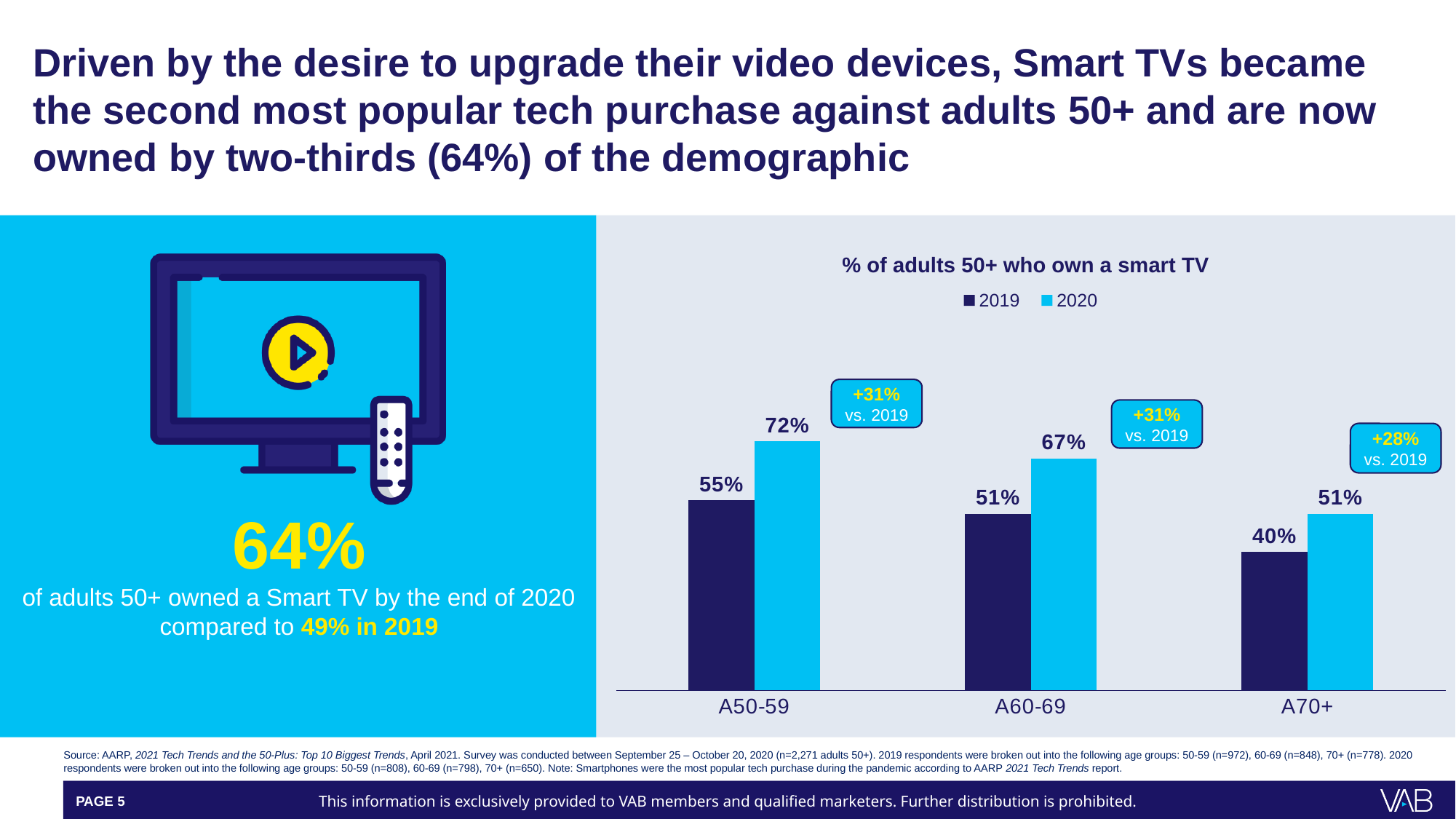
Which is larger: the 2019 value for A50-59 or the 2020 value for A70+? 2019 value for A50-59 What is the difference in percentage points between the 2020 and 2019 values for A70+? 11 How many age groups are shown on the x axis of the chart? 3 What type of chart is shown on the slide? Bar chart How many series does the chart legend list? 2 Which age group has the highest smart TV ownership in 2020? A50-59 What percentage of adults aged 70+ owned a smart TV in 2019? 40% What is the difference in percentage points between the 2020 values for A50-59 and A60-69? 5 What is the 2020 value for the A60-69 age group? 67% Which age group has the lowest smart TV ownership in 2019? A70+ What is the title of the chart? % of adults 50+ who own a smart TV What percentage of adults aged 50-59 owned a smart TV in 2020? 72%